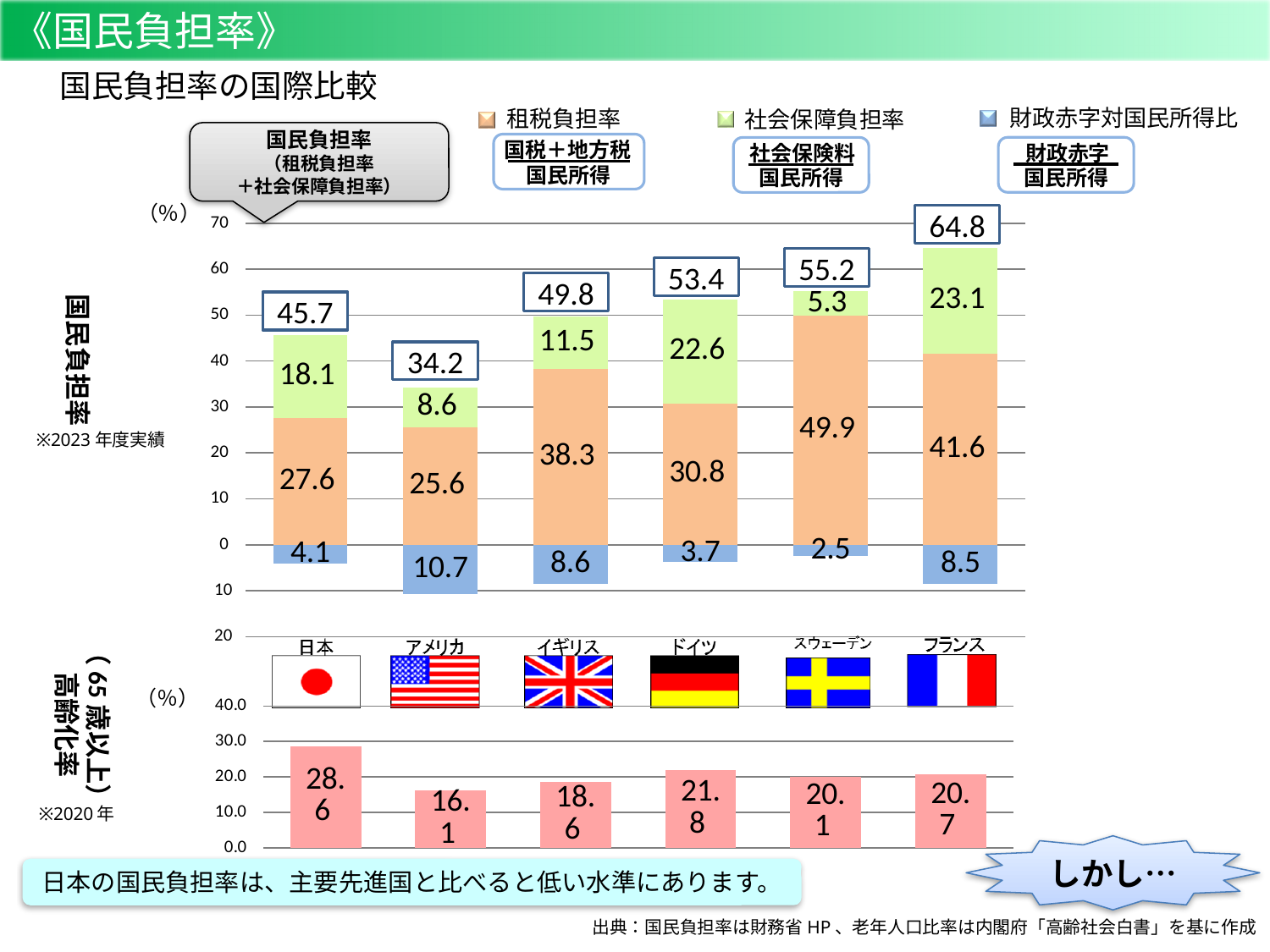
In the top chart (国民負担率), what is the 財政赤字対国民所得比 value for アメリカ (USA)? 10.7 In the top chart (国民負担率), what is the 租税負担率 (tax burden) value for スウェーデン (Sweden)? 49.9 In the bottom chart (高齢化率), what is the value for 日本 (Japan)? 28.6 In the top chart (国民負担率), what is the total national burden rate shown for フランス (France)? 64.8 In the top chart (国民負担率), which country has the lowest total national burden rate? アメリカ (USA) How many countries are shown in the top chart (国民負担率)? 6 In the top chart (国民負担率), which country has the highest total national burden rate? フランス (France) How many series does the legend of the top chart (国民負担率) list? 3 In the top chart (国民負担率), what is the difference between the total for フランス (64.8) and 日本 (45.7)? 19.1 In the top chart (国民負担率), which is larger: the 社会保障負担率 value for ドイツ or for イギリス? ドイツ (22.6) In the bottom chart (高齢化率), which country has the lowest aging rate? アメリカ (USA) What kind of chart is the top chart (国民負担率)? Stacked bar chart